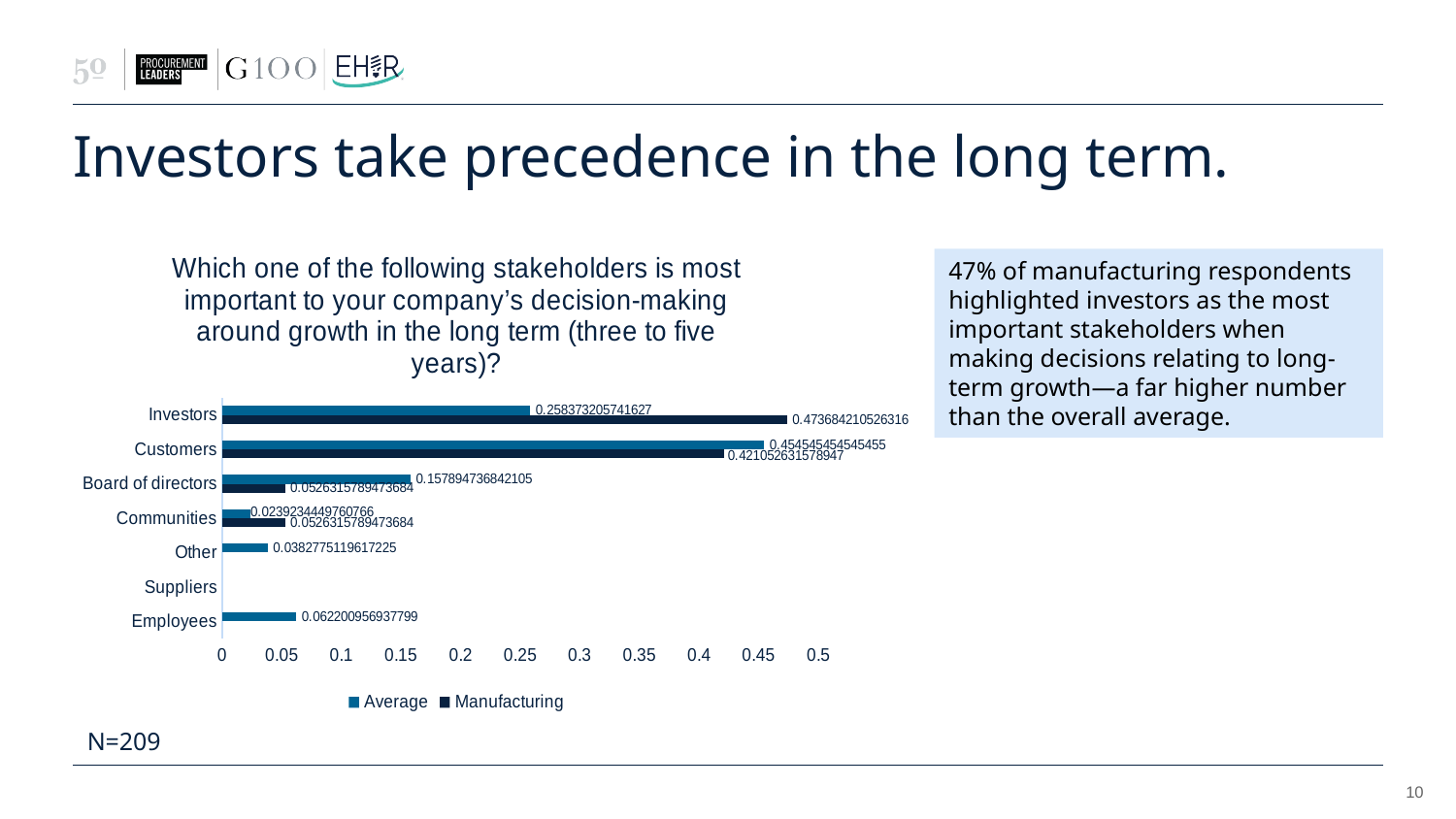
What is the Average value for Customers? 0.454545454545455 What is the Manufacturing value for Board of directors? 0.0526315789473684 How many stakeholder categories are listed on the chart? 7 What is the Average value for Employees? 0.062200956937799 Which category has the highest Manufacturing value? Investors Is the Average value for Board of directors greater or less than 0.1? greater For Investors, which is larger, the Average value or the Manufacturing value? Manufacturing What kind of chart is shown on the slide? Bar chart How many series does the legend list? 2 What is the Manufacturing value for Investors? 0.473684210526316 Which category has the highest Average value? Customers What is the Average value for Investors? 0.258373205741627